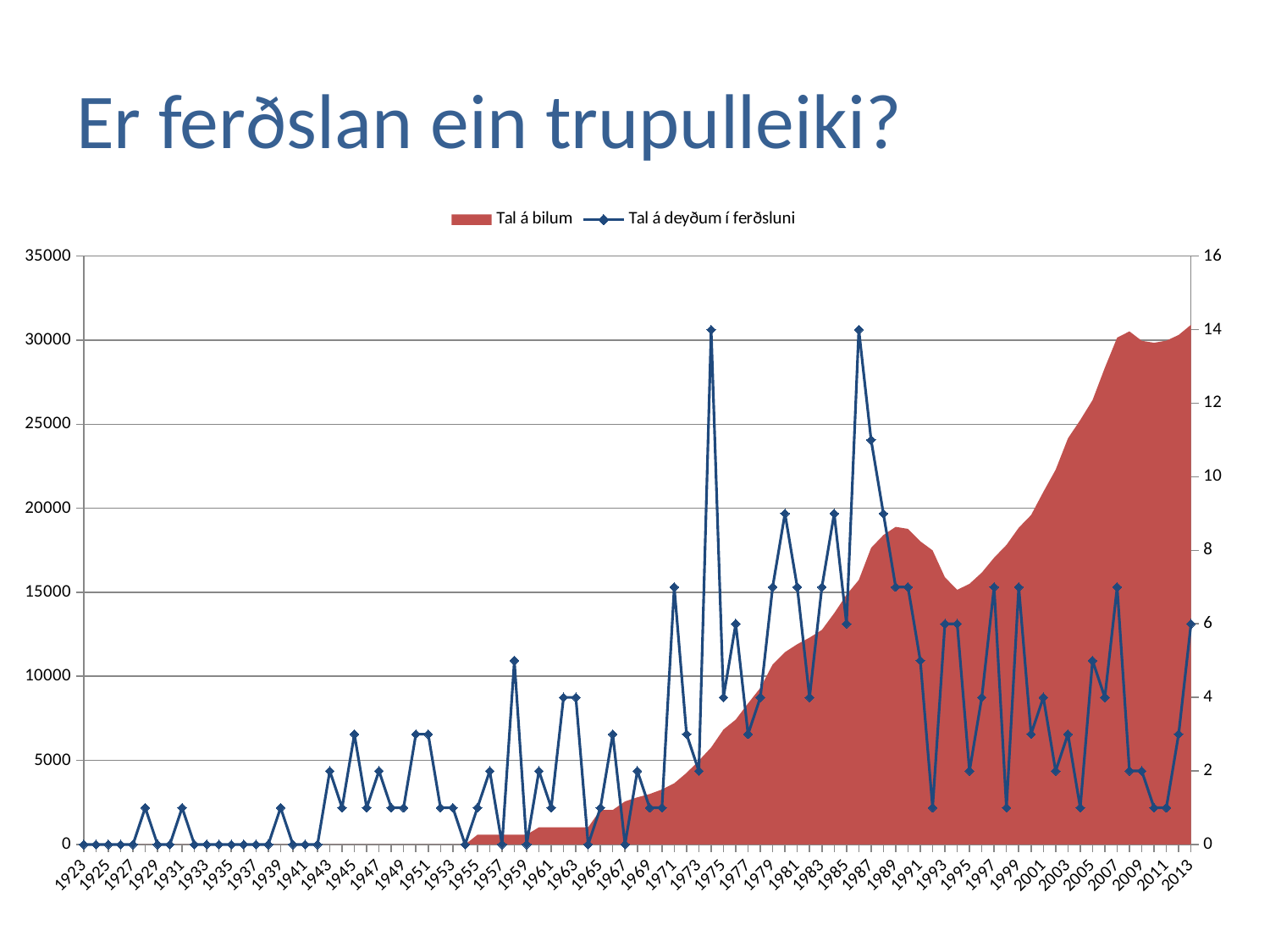
Is the value of Tal á bilum in 1989 greater or less than 20000? less What is the value of Tal á deyðum í ferðsluni in 2013? 6 Does Tal á bilum generally rise or fall from 1923 to 2013? rise What kind of chart is shown on the slide? A combined area and line chart What is the difference between Tal á deyðum í ferðsluni in 1975 and in 1976? 2 What is the value of Tal á deyðum í ferðsluni in 1923? 0 In which two years does the Tal á deyðum í ferðsluni line reach its peak of 14? 1974 and 1986 Is the value of Tal á bilum in 2013 greater or less than 30000? greater Is the value of Tal á bilum in 1969 greater or less than 5000? less What are the two series named in the legend? Tal á bilum and Tal á deyðum í ferðsluni How many series does the legend list? 2 What is the highest value reached by the Tal á deyðum í ferðsluni line on the right axis? 14